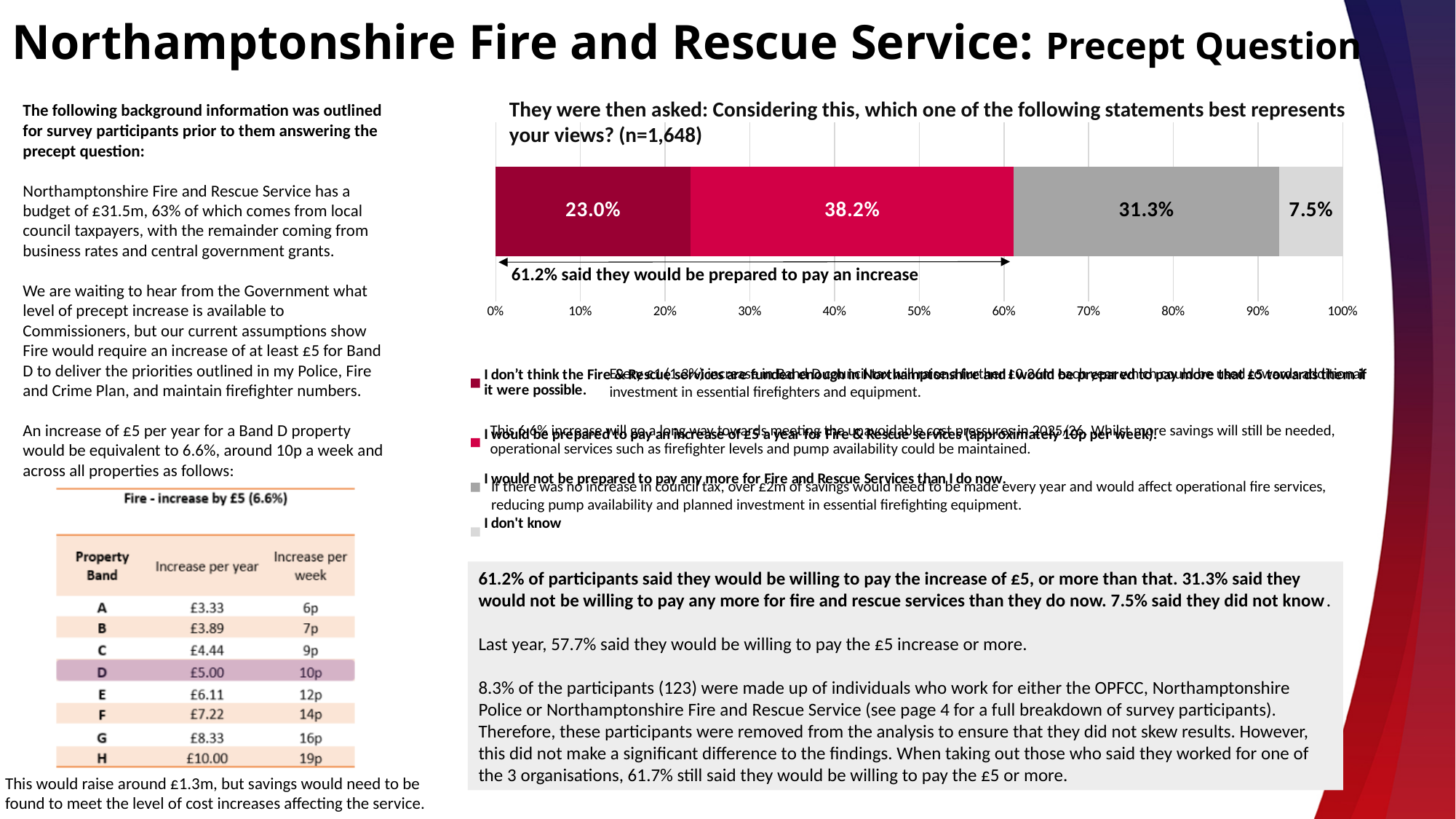
What percentage of respondents said 'I don't know'? 7.5% How many response categories does the legend list? 4 What percentage of respondents said they would not be prepared to pay any more for Fire and Rescue Services than they do now? 31.3% What percentage of respondents said they would be prepared to pay more than £5 towards Fire & Rescue services? 23.0% Which is larger: the share who would pay more than £5 (23.0%) or the share who would not pay any more (31.3%)? Would not pay any more (31.3%) Which response has the largest share in the bar? I would be prepared to pay an increase of £5 a year (38.2%) Which response has the smallest share in the bar? I don't know (7.5%) What percentage of respondents said they would be prepared to pay an increase of £5 a year for Fire & Rescue services? 38.2% According to the annotation under the bar, what percentage said they would be prepared to pay an increase? 61.2% What is the difference in percentage points between the 38.2% segment and the 31.3% segment? 6.9 percentage points What kind of chart is shown on the slide? Stacked bar chart What is the total of all four segments in the stacked bar? 100.0%